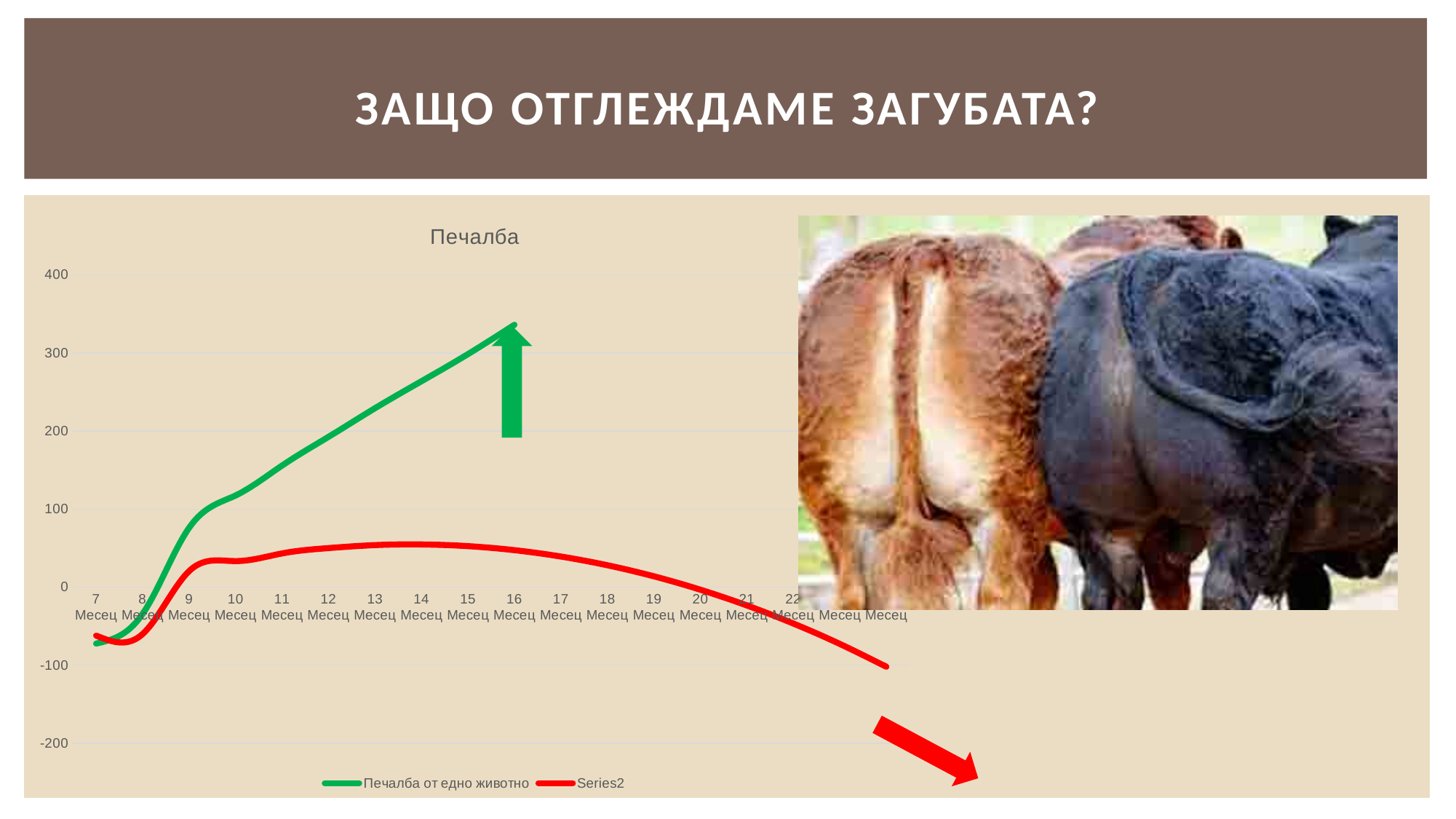
Is the value of "Печалба от едно животно" at 7 Месец greater or less than 0? less What kind of chart is shown on the slide? line chart Is the value of Series2 at 22 Месец greater or less than 0? less Does the Series2 line rise or fall from 14 Месец to 22 Месец? fall Does the "Печалба от едно животно" line rise or fall from 7 Месец to 16 Месец? rise What is the title of the chart? Печалба Is the value of "Печалба от едно животно" at 14 Месец greater or less than 200? greater What colour is the line for the series "Печалба от едно животно"? green At 14 Месец, which series has the larger value, "Печалба от едно животно" or Series2? Печалба от едно животно How many series does the chart legend list? 2